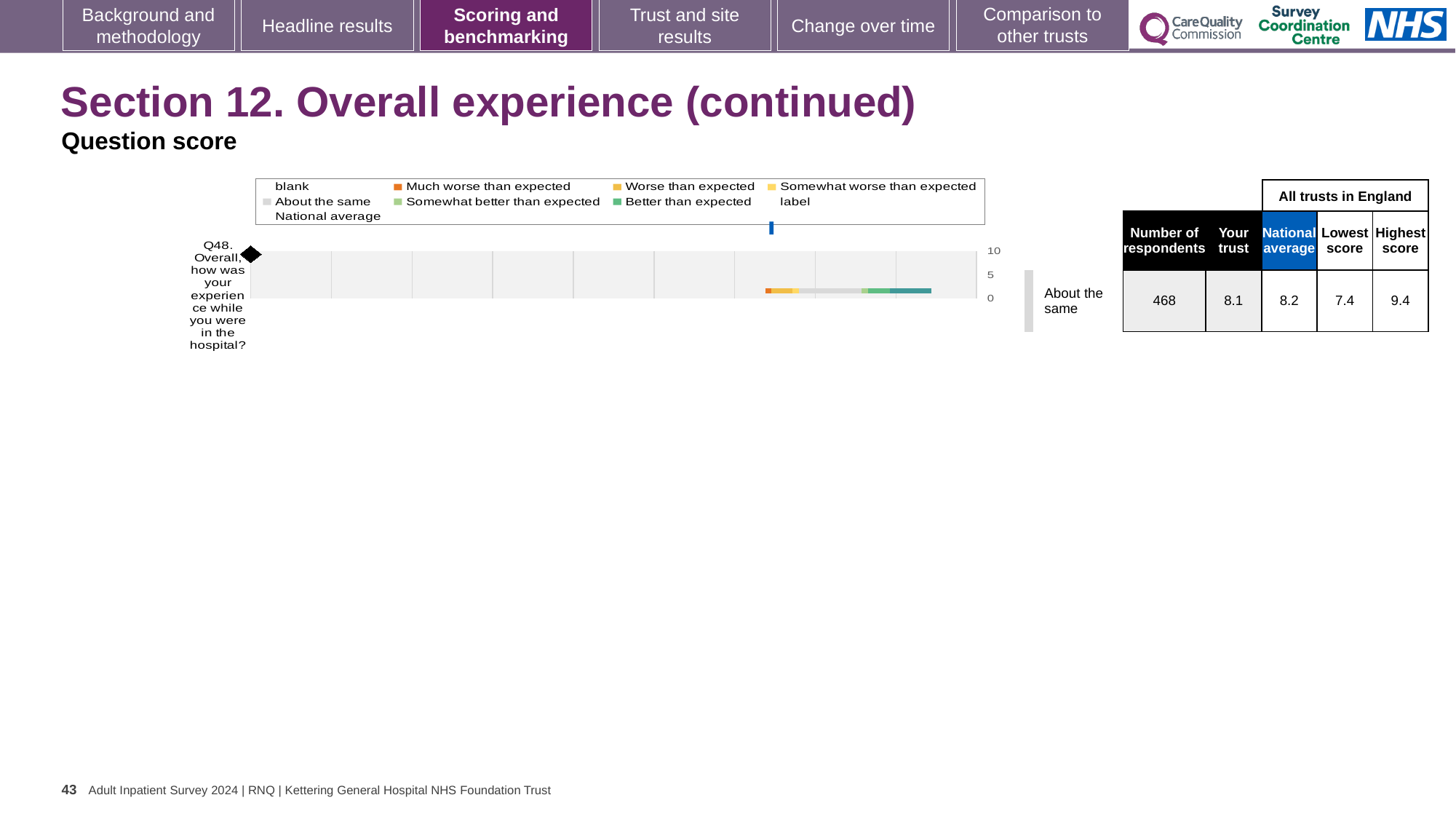
What is the 'Your trust' score for Q48? 8.1 What is the lowest score among all trusts in England for Q48? 7.4 What is the difference between the national average and the 'Your trust' score for Q48? 0.1 Which is larger for Q48, the 'Your trust' score or the national average? National average How many survey questions are plotted in the chart? 1 What kind of chart is shown for Q48? bar chart What is the highest score among all trusts in England for Q48? 9.4 Which benchmarking category is the trust's Q48 result placed in? About the same Which legend entry is shown in orange? Much worse than expected What is the difference between the highest score and the lowest score for Q48? 2.0 How many respondents answered Q48? 468 What is the national average score for Q48? 8.2